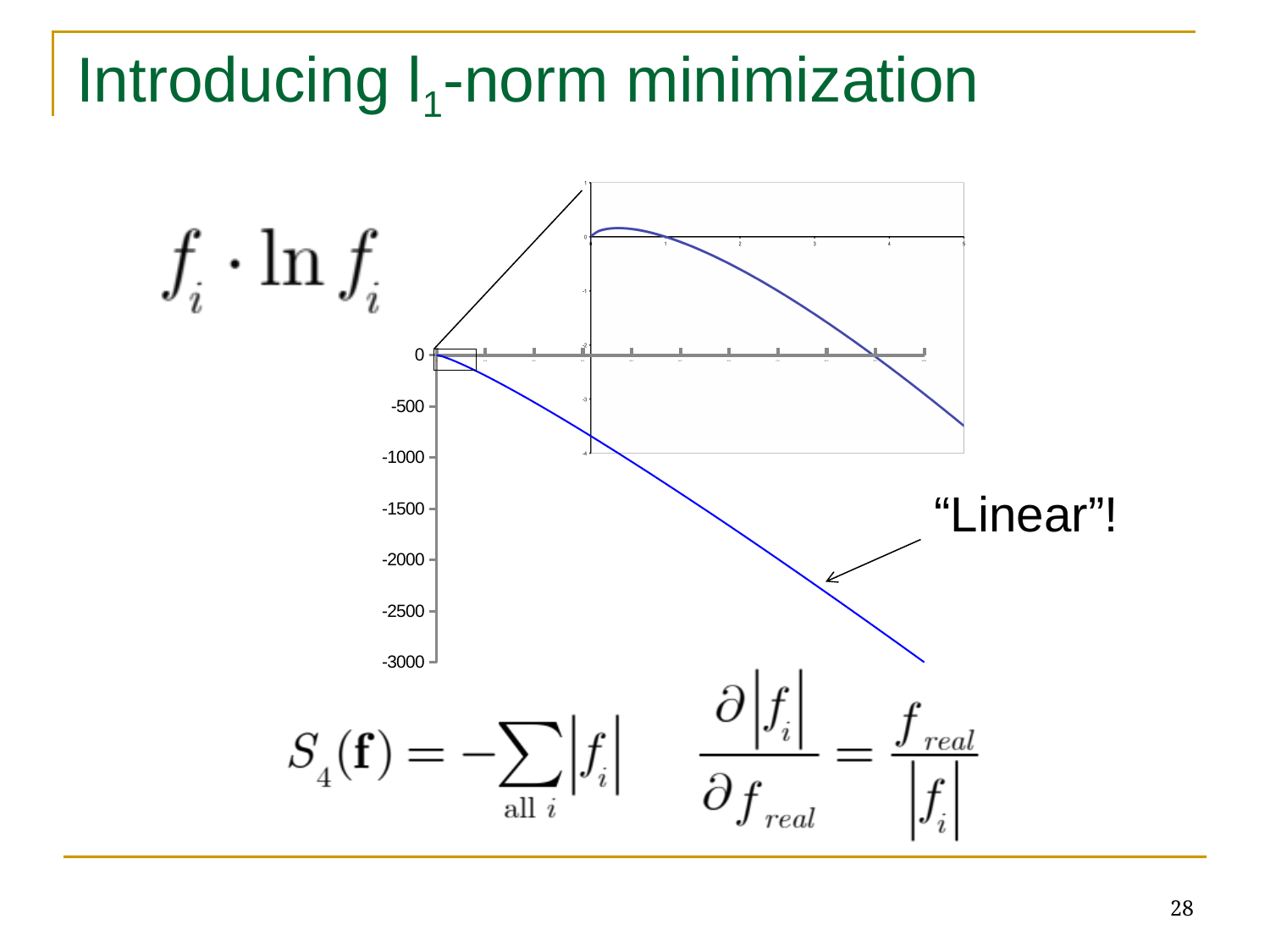
In the main chart, is the value of the curve at the right end of the x axis greater or less than -2500? less What kind of chart is shown on the slide? line chart How many lines are plotted in the main chart? 1 Does the plotted curve in the main chart rise or fall as you move along the x axis from left to right? fall What is the lowest tick label shown on the y axis of the main chart? -3000 In the inset (zoomed) chart, is the value of the curve at x = 5 greater or less than -2? less What is the lowest tick label on the y axis of the inset (zoomed) chart? -4 What word is written in the annotation pointing at the curve in the main chart? "Linear"! In the main chart, is the value of the curve at the left end of the x axis greater or less than -500? greater